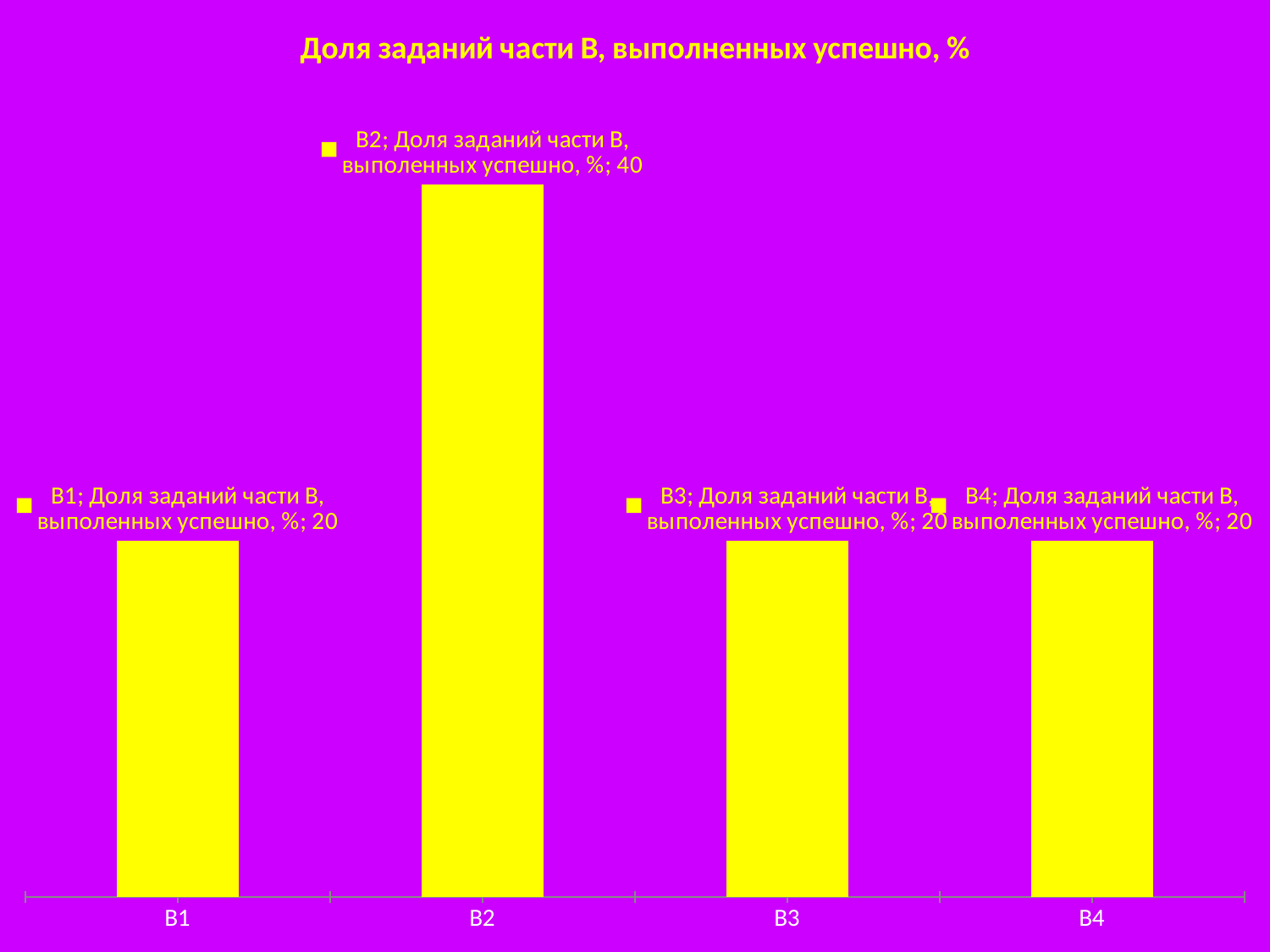
What is the value for B4? 20 What is the title of the chart? Доля заданий части В, выполненных успешно, % Which category has the highest value? B2 What is the difference between the values for B2 and B3? 20 What is the value for B2? 40 What is the value for B1? 20 What colour are the bars? yellow How many categories are shown on the x axis? 4 Which is larger, the value for B2 or the value for B1? B2 What is the total of the values for B1, B3 and B4? 60 What kind of chart is this? bar chart